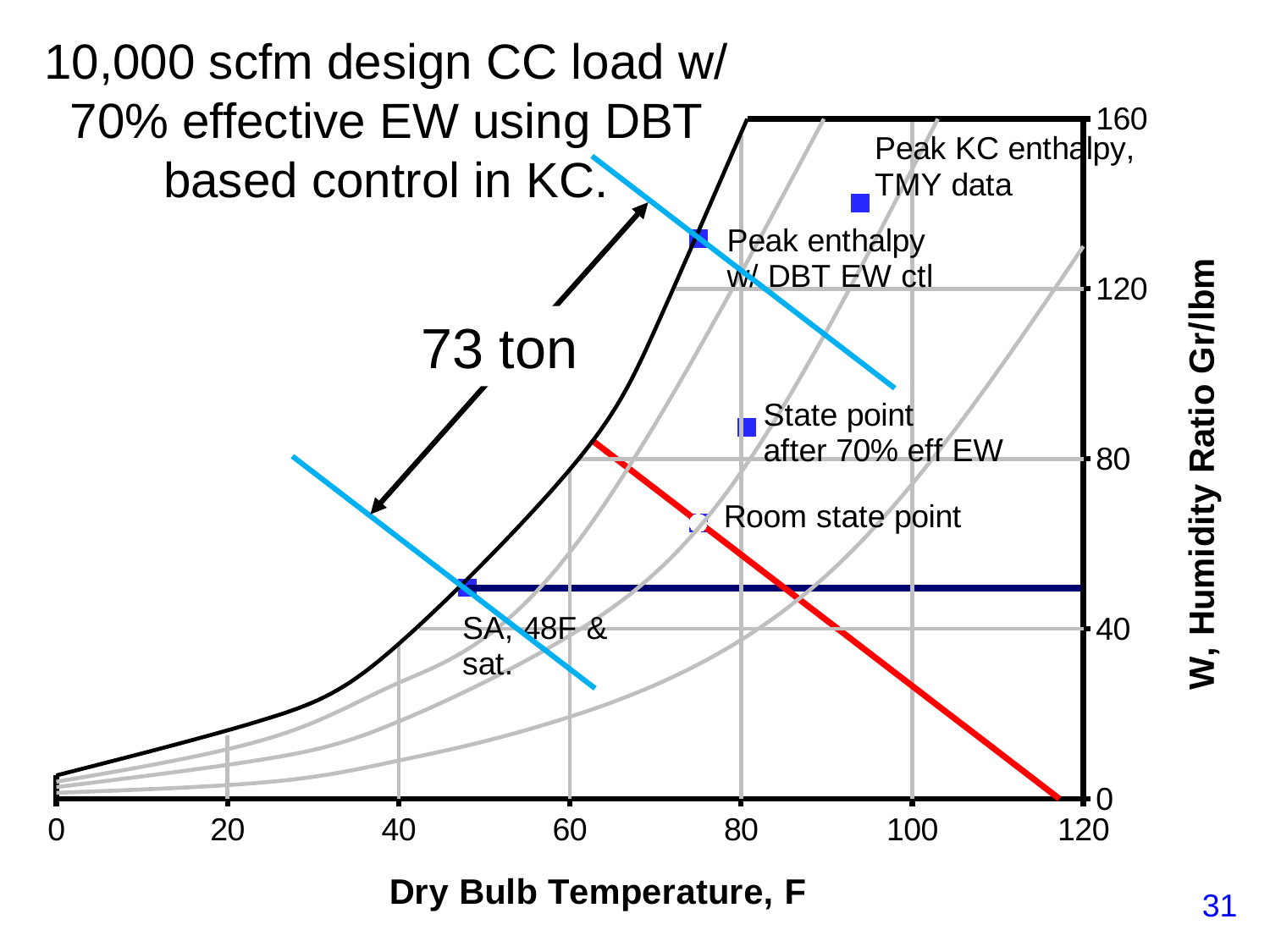
How many labeled state points are marked on the chart? 5 What is the y-axis title of the chart? W, Humidity Ratio Gr/lbm Is the humidity ratio of the 'Room state point' greater or less than 80 Gr/lbm? less Is the dry bulb temperature of the 'Peak KC enthalpy, TMY data' point greater or less than 80 F? greater Which has the higher humidity ratio, the 'Peak enthalpy w/ DBT EW ctl' point or the 'State point after 70% eff EW'? Peak enthalpy w/ DBT EW ctl Is the humidity ratio of the 'SA, 48F & sat.' point greater or less than 40 Gr/lbm? greater What is the x-axis title of the chart? Dry Bulb Temperature, F What kind of chart is shown on the slide? line chart (psychrometric chart) What is the maximum value shown on the humidity ratio axis? 160 Which labeled state point has the lowest humidity ratio? SA, 48F & sat. Which labeled state point has the highest humidity ratio? Peak KC enthalpy, TMY data